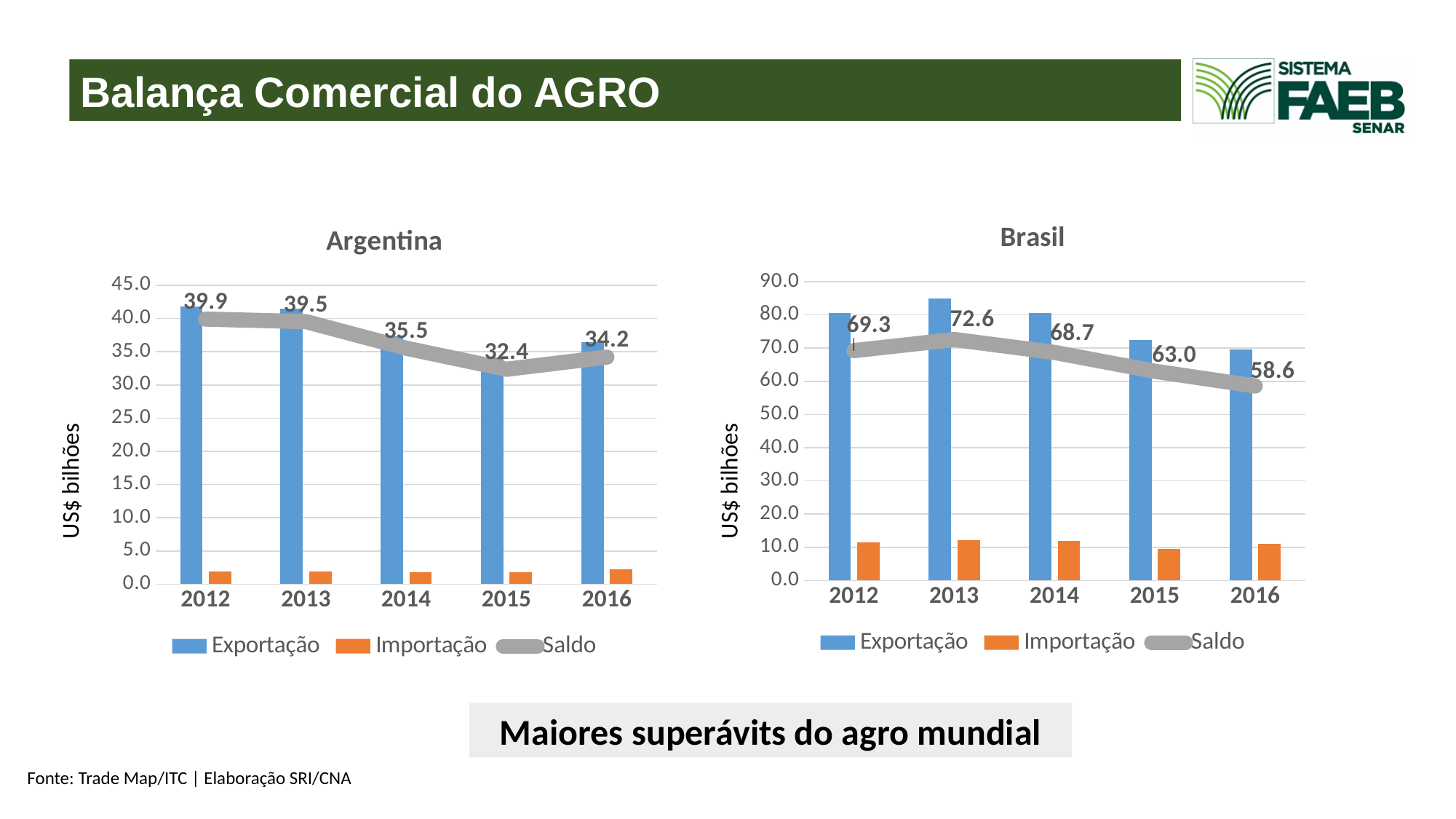
How many years are shown on the x axis of the Brasil chart? 5 In the Argentina chart, what is the Saldo value for 2012? 39.9 What kind of chart is the Brasil chart? Combined bar and line chart In the Brasil chart, is the Exportação value for 2013 greater or less than 80.0? greater In the Argentina chart, which year has the lowest Saldo? 2015 In the Brasil chart, which year has the highest Saldo? 2013 In the Brasil chart, what is the difference between the Saldo in 2013 and the Saldo in 2016? 14.0 How many series does the legend of the Argentina chart list? 3 In the Brasil chart, does the Saldo rise or fall from 2013 to 2016? fall In the Argentina chart, is the Importação value for 2014 greater or less than 5.0? less In the Brasil chart, what is the Saldo value for 2016? 58.6 In the Argentina chart, is the Saldo for 2014 larger or smaller than the Saldo for 2016? larger